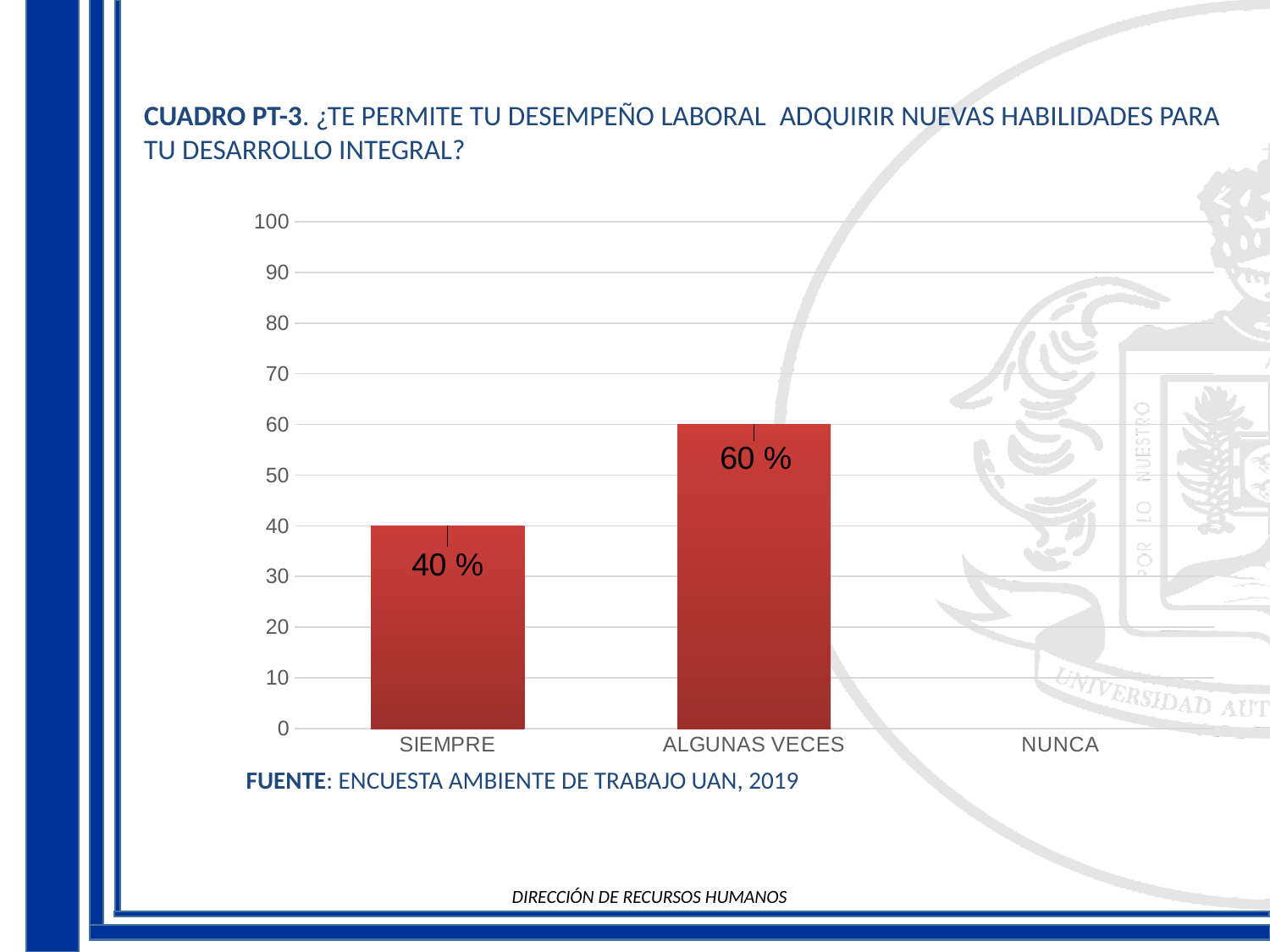
Which is larger, the value for SIEMPRE or the value for ALGUNAS VECES? ALGUNAS VECES Is the value for SIEMPRE greater or less than 50? less How many categories are shown on the x axis? 3 Is the value for ALGUNAS VECES greater or less than 50? greater What is the highest value shown on the y axis? 100 What kind of chart is shown on the slide? bar chart What is the difference between the values for ALGUNAS VECES and SIEMPRE? 20 % What source is cited below the chart? ENCUESTA AMBIENTE DE TRABAJO UAN, 2019 Which category has the highest value? ALGUNAS VECES What is the value shown for ALGUNAS VECES? 60 % What is the value shown for SIEMPRE? 40 %